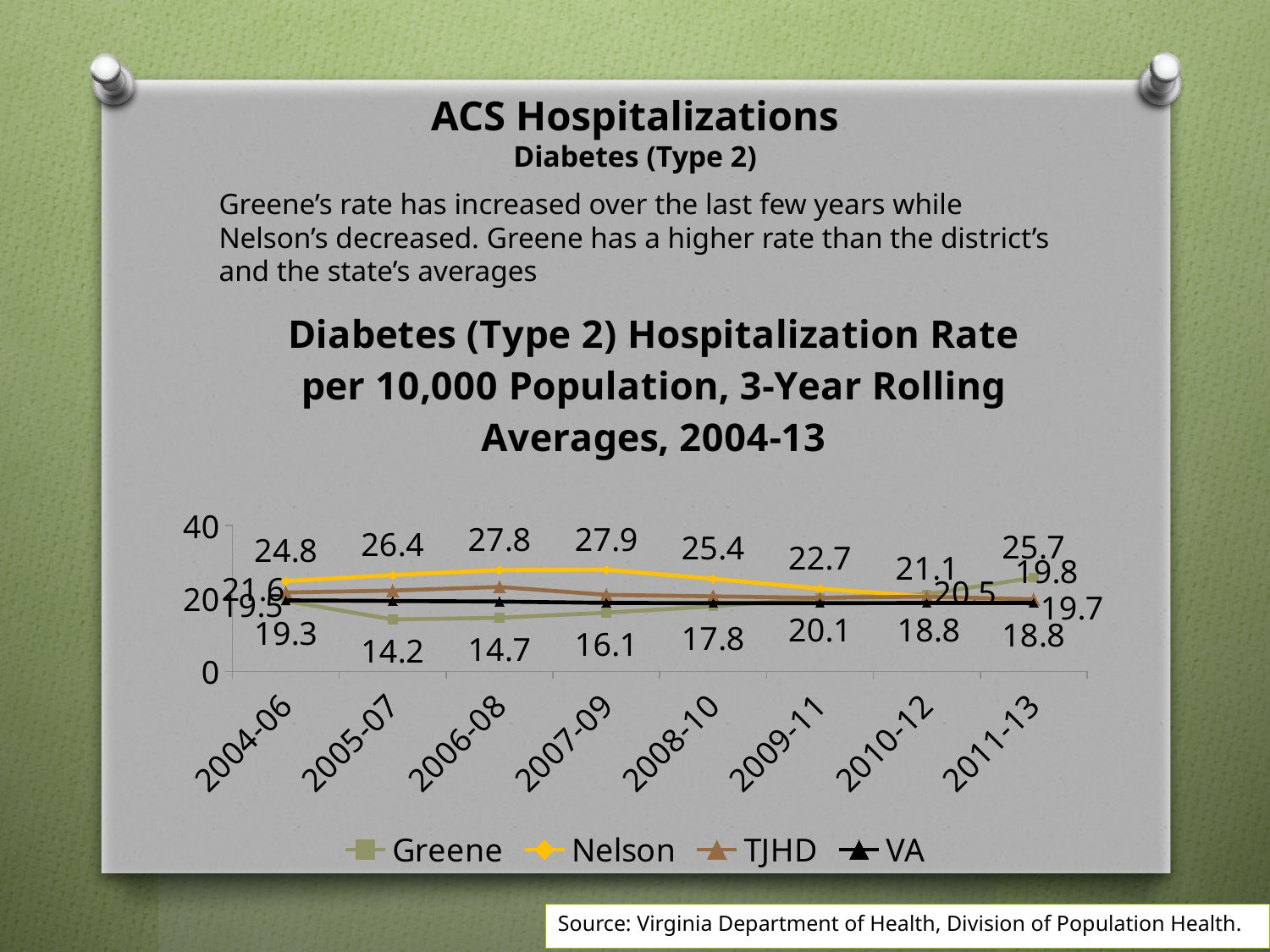
Which is larger in 2005-07, Nelson or Greene? Nelson What is the value for Nelson in 2006-08? 27.8 In which period is Greene's rate lowest? 2005-07 What is the value for Greene in 2005-07? 14.2 What is the value for Nelson in 2009-11? 22.7 How many time periods are shown on the x axis? 8 Is the value for Nelson in 2006-08 greater or less than 20? greater What is the value for Greene in 2011-13? 25.7 How many series does the legend list? 4 What kind of chart is shown on the slide? line chart In which period is Nelson's rate highest? 2007-09 What is the difference between Nelson's and Greene's values in 2007-09? 11.8